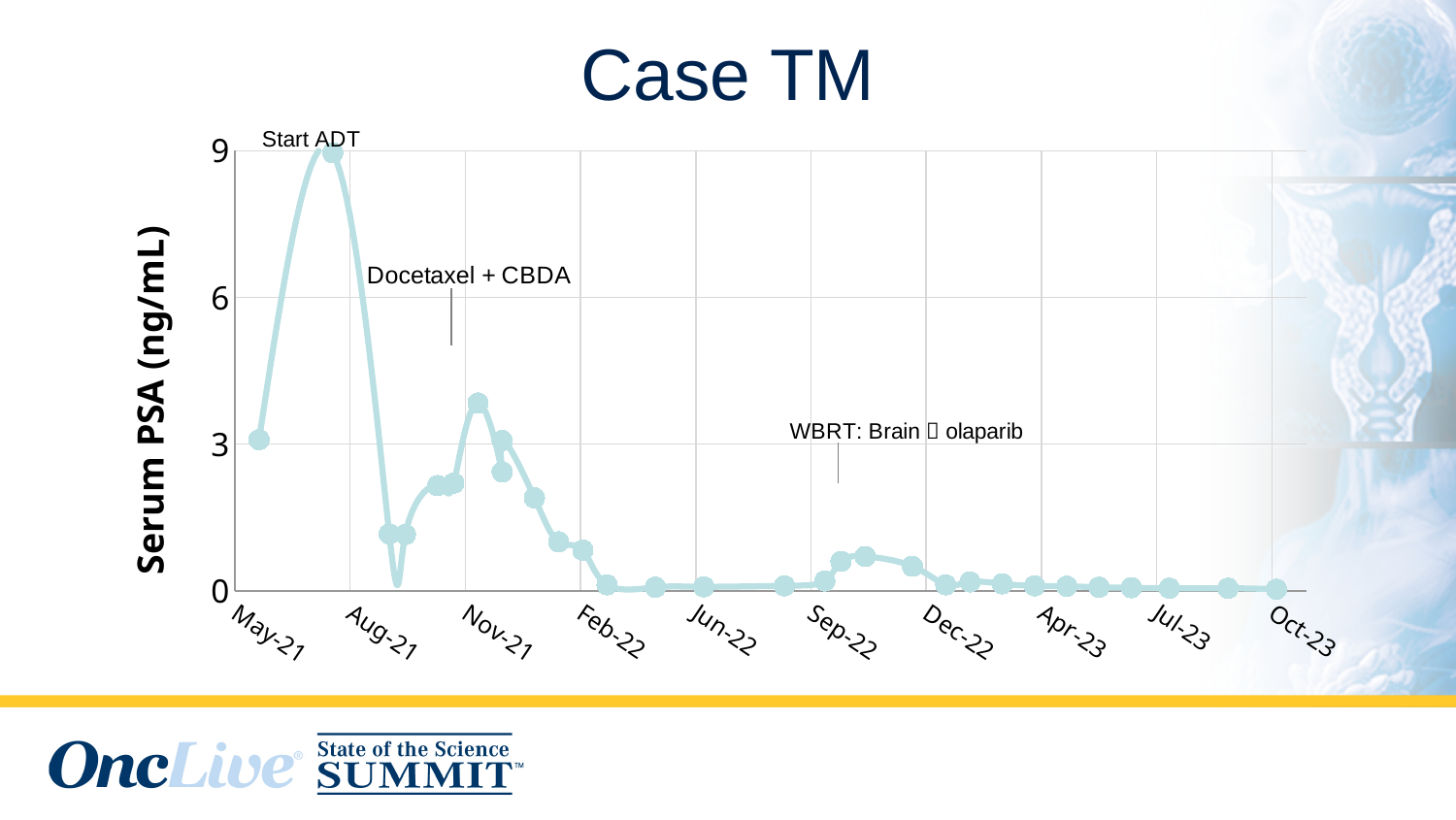
What is the title of the chart on the slide? Case TM Is the serum PSA value at Oct-23 greater or less than 3? less What kind of chart is shown on the slide? line chart Which is larger, the serum PSA value at Nov-21 or at Jun-22? Nov-21 Does the serum PSA value rise or fall between Nov-21 and Feb-22? fall What is the label of the vertical axis? Serum PSA (ng/mL) How many month labels are shown along the x axis? 10 Which is larger, the serum PSA value at Sep-22 or at Jul-23? Sep-22 Is the peak serum PSA value near the 'Start ADT' annotation greater or less than 6? greater